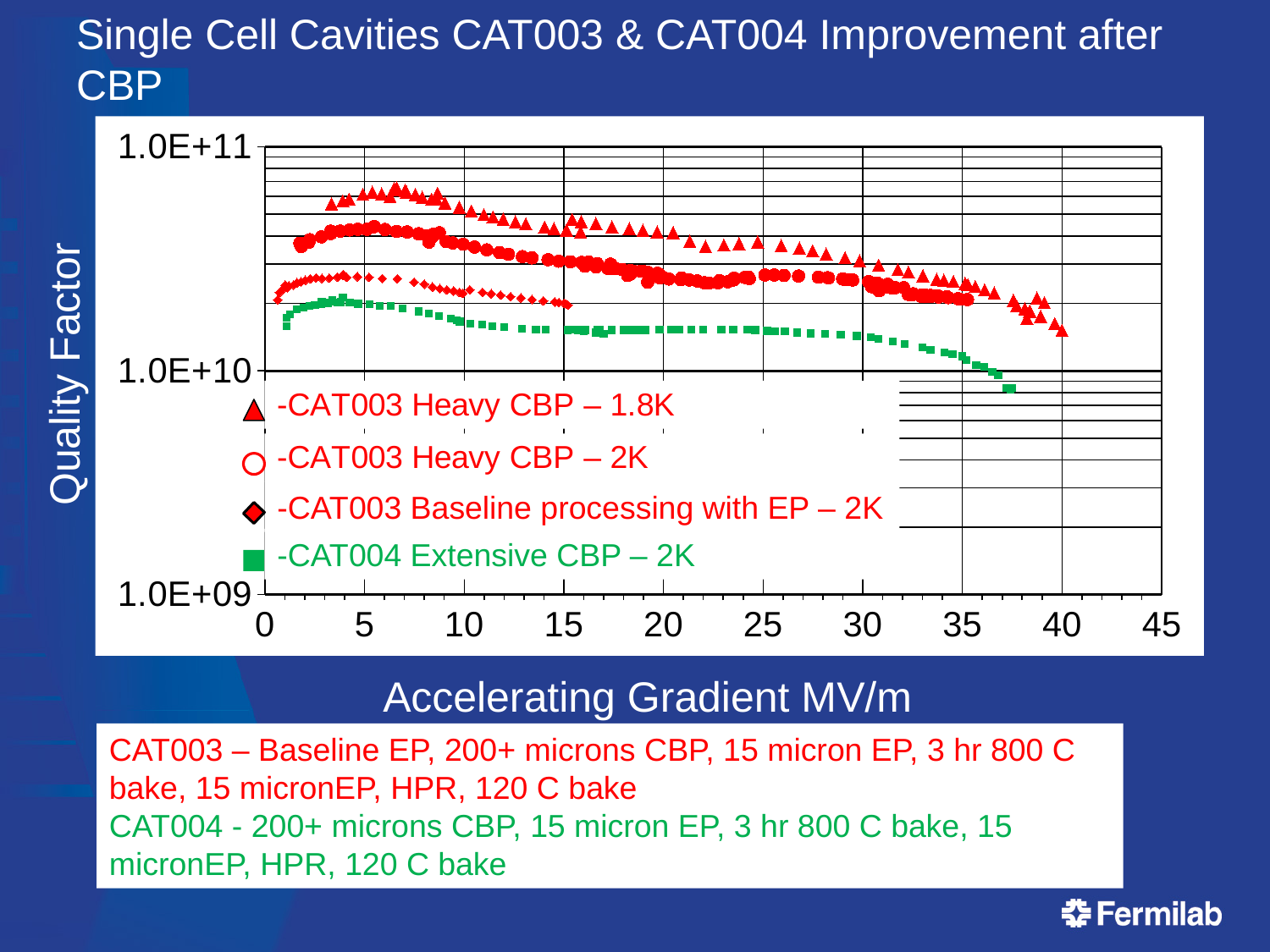
Which series extends to the highest accelerating gradient? CAT003 Heavy CBP – 1.8K How many series does the legend list? 4 Is the highest quality factor of CAT003 Heavy CBP – 1.8K greater or less than 1.0E+11? less Between 10 and 40 MV/m, does the quality factor of CAT003 Heavy CBP – 1.8K rise or fall as the accelerating gradient increases? fall Is the quality factor of CAT004 Extensive CBP – 2K at 20 MV/m greater or less than 1.0E+10? greater What is the title of the x axis? Accelerating Gradient MV/m What kind of chart is shown on the slide? scatter chart At 20 MV/m, which series has the higher quality factor: CAT003 Heavy CBP – 1.8K or CAT004 Extensive CBP – 2K? CAT003 Heavy CBP – 1.8K Which series has the lowest quality factor values on the chart? CAT004 Extensive CBP – 2K Which series is plotted with green square markers? CAT004 Extensive CBP – 2K Which series reaches the highest quality factor on the chart? CAT003 Heavy CBP – 1.8K Which series ends at the lowest accelerating gradient? CAT003 Baseline processing with EP – 2K